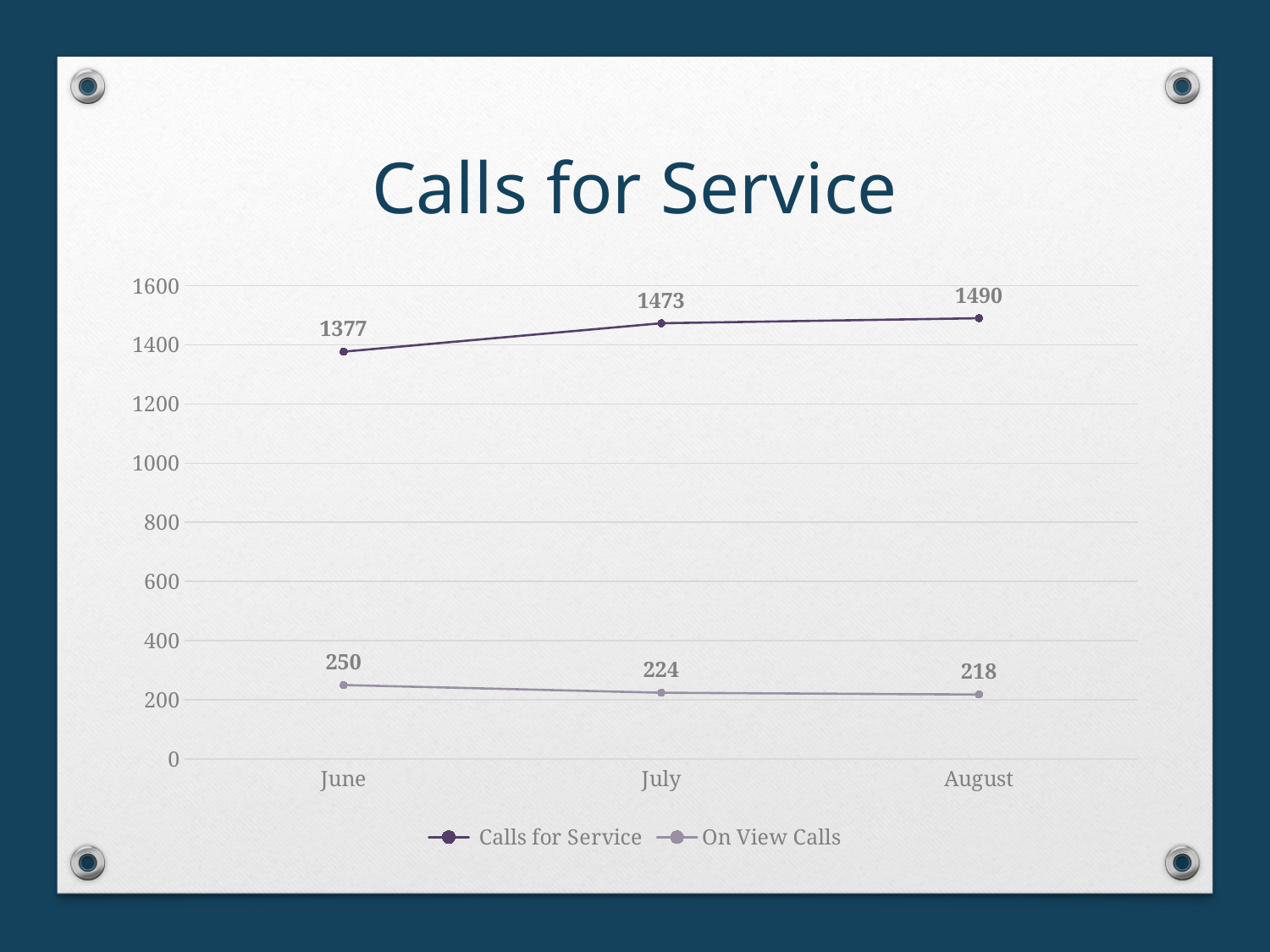
What is the difference between Calls for Service in August and in June? 113 Which is larger, Calls for Service in June or Calls for Service in July? July How many series does the legend list? 2 In which month is Calls for Service highest? August What is the value for On View Calls in June? 250 In which month is On View Calls lowest? August What is the difference between On View Calls in June and in July? 26 What is the value for Calls for Service in July? 1473 Do the On View Calls values rise or fall from June to August? fall What is the value for On View Calls in August? 218 What kind of chart is shown on the slide? line chart How many months are shown on the x axis? 3